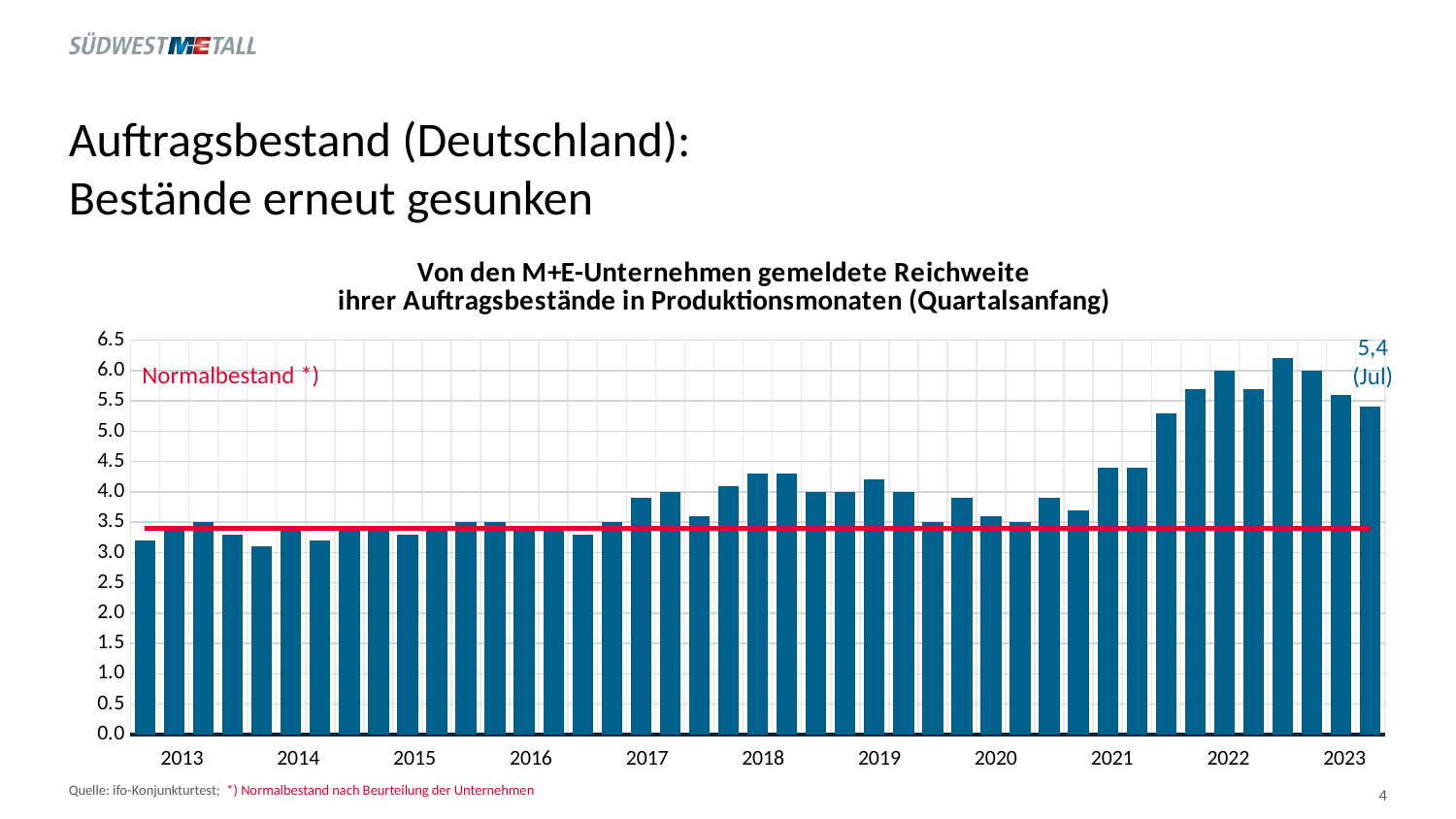
Is the highest bar in 2022 greater or less than 5.5? greater In which year does the highest bar of the chart occur? 2022 What source is cited for the chart? ifo-Konjunkturtest What label is given to the red horizontal line in the chart? Normalbestand *) Is the value of the first bar in 2013 greater or less than 3.5? less Do the bars rise or fall from the start of 2020 to the end of 2022? rise How many year labels are shown on the x axis? 11 What kind of chart is shown on the slide? bar chart What value is printed for the most recent bar (Jul 2023)? 5,4 Which month is given in the data label next to the last bar? Jul Is the Jul 2023 value greater or less than 5.0? greater Are the bars in 2022 larger or smaller than the bars in 2013? larger